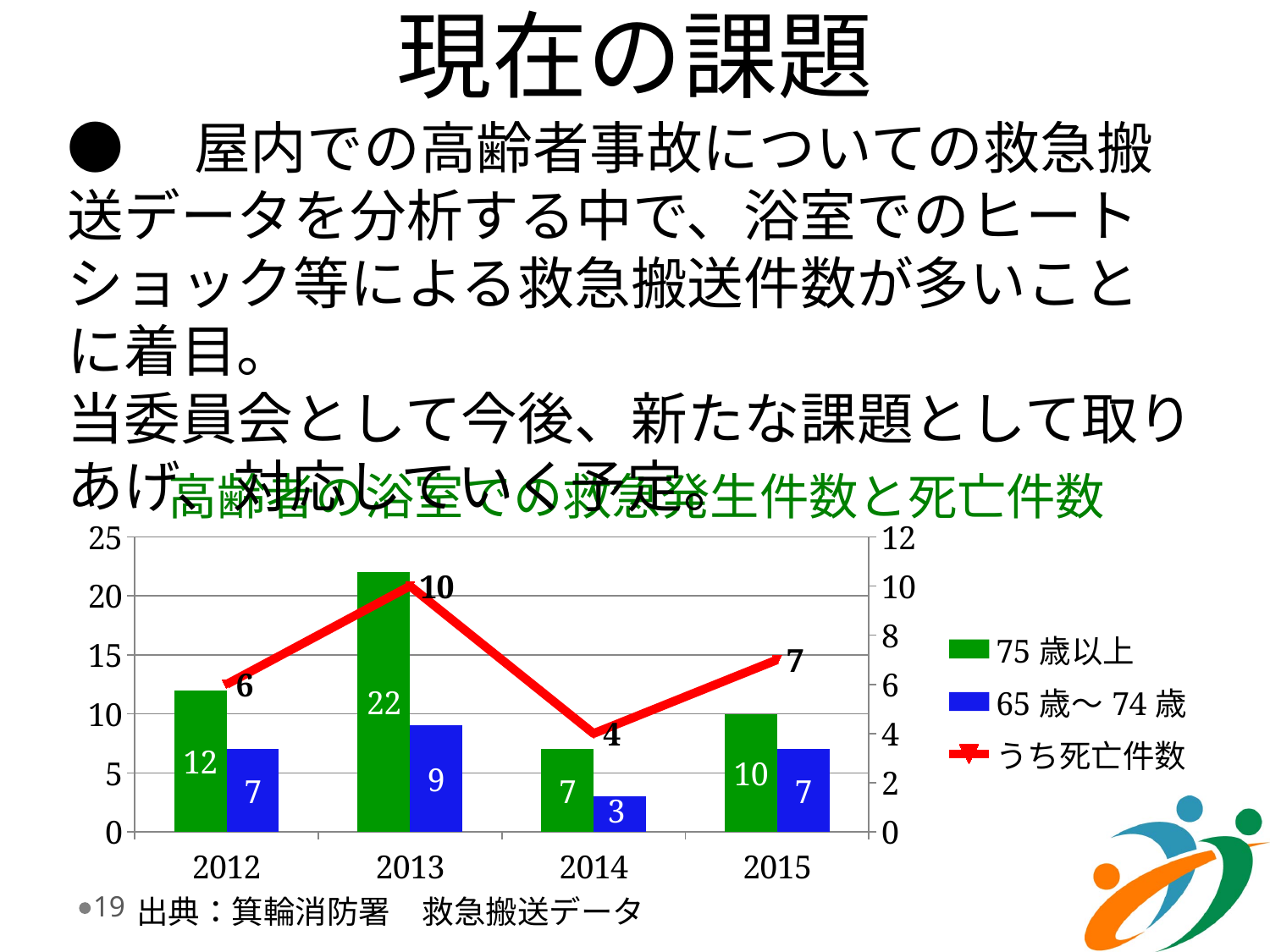
In which year is the value for 65歳～74歳 lowest? 2014 What kind of chart is this? Combined bar and line chart What is the difference between the 75歳以上 value and the 65歳～74歳 value in 2013? 13 What is the value for 65歳～74歳 in 2014? 3 In which year is the value for 75歳以上 highest? 2013 Does the うち死亡件数 line rise or fall from 2013 to 2014? Fall How many years are shown on the x axis? 4 What is the value for 75歳以上 in 2013? 22 How many series does the legend list? 3 What is the title of the chart? 高齢者の浴室での救急発生件数と死亡件数 Which is larger in 2015: the value for 75歳以上 or the value for 65歳～74歳? 75歳以上 What is the value of うち死亡件数 in 2012? 6